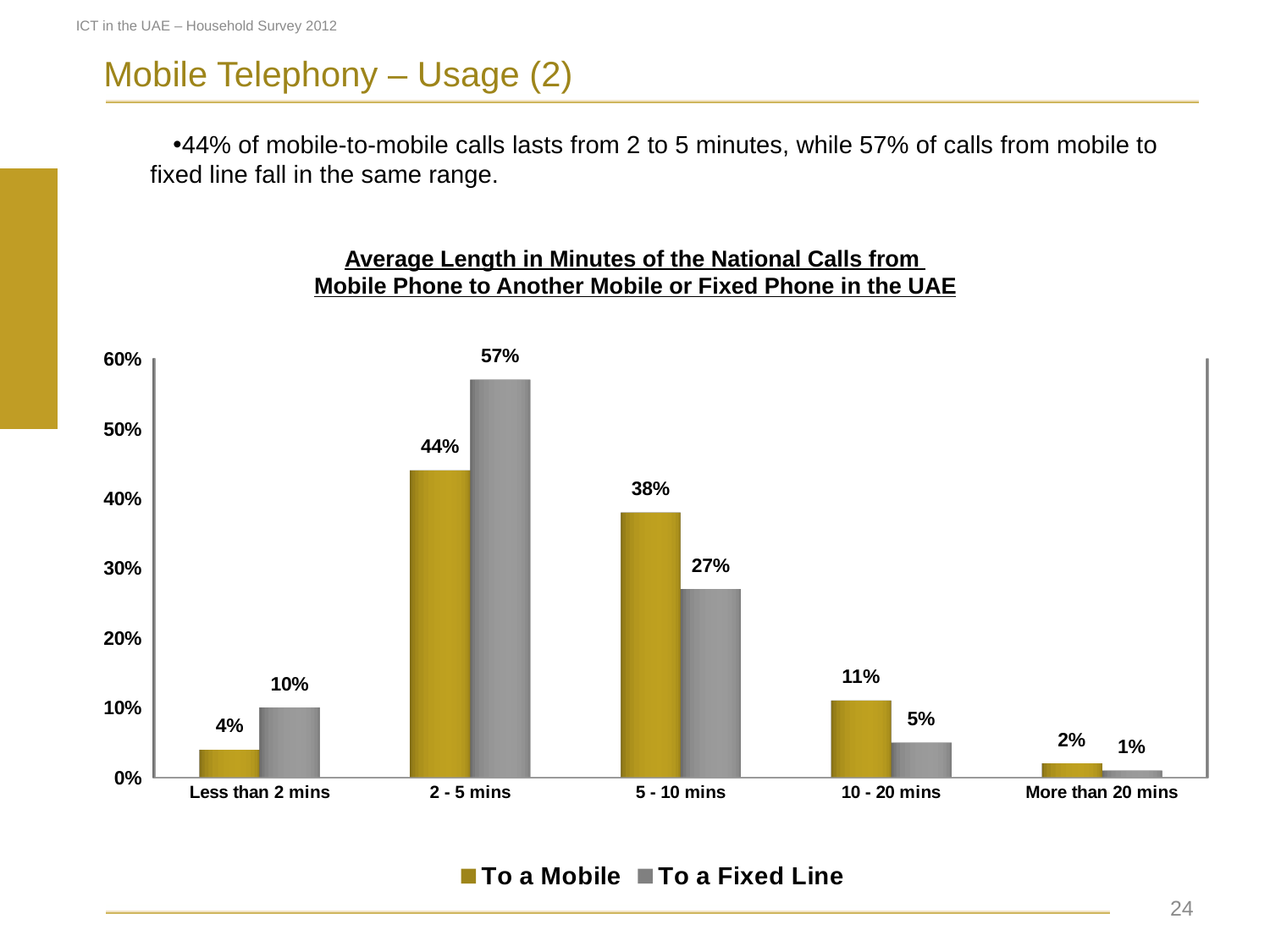
What is the difference between the 'To a Fixed Line' and 'To a Mobile' values for 2 - 5 mins? 13% Which call length category has the highest value for 'To a Fixed Line'? 2 - 5 mins Is the value for 'To a Mobile' in the 10 - 20 mins category greater or less than 20%? less How many call length categories are shown on the x axis? 5 Which colour represents 'To a Fixed Line' in the chart? Grey What percentage of calls to a fixed line last 5 - 10 mins? 27% Which call length category has the lowest value for 'To a Mobile'? More than 20 mins How many series does the legend list? 2 What kind of chart is shown on the slide? Bar chart What percentage of calls to a mobile last 2 - 5 mins? 44% For 5 - 10 mins, which series has the larger value, 'To a Mobile' or 'To a Fixed Line'? To a Mobile What is the value for 'To a Fixed Line' in the 'Less than 2 mins' category? 10%